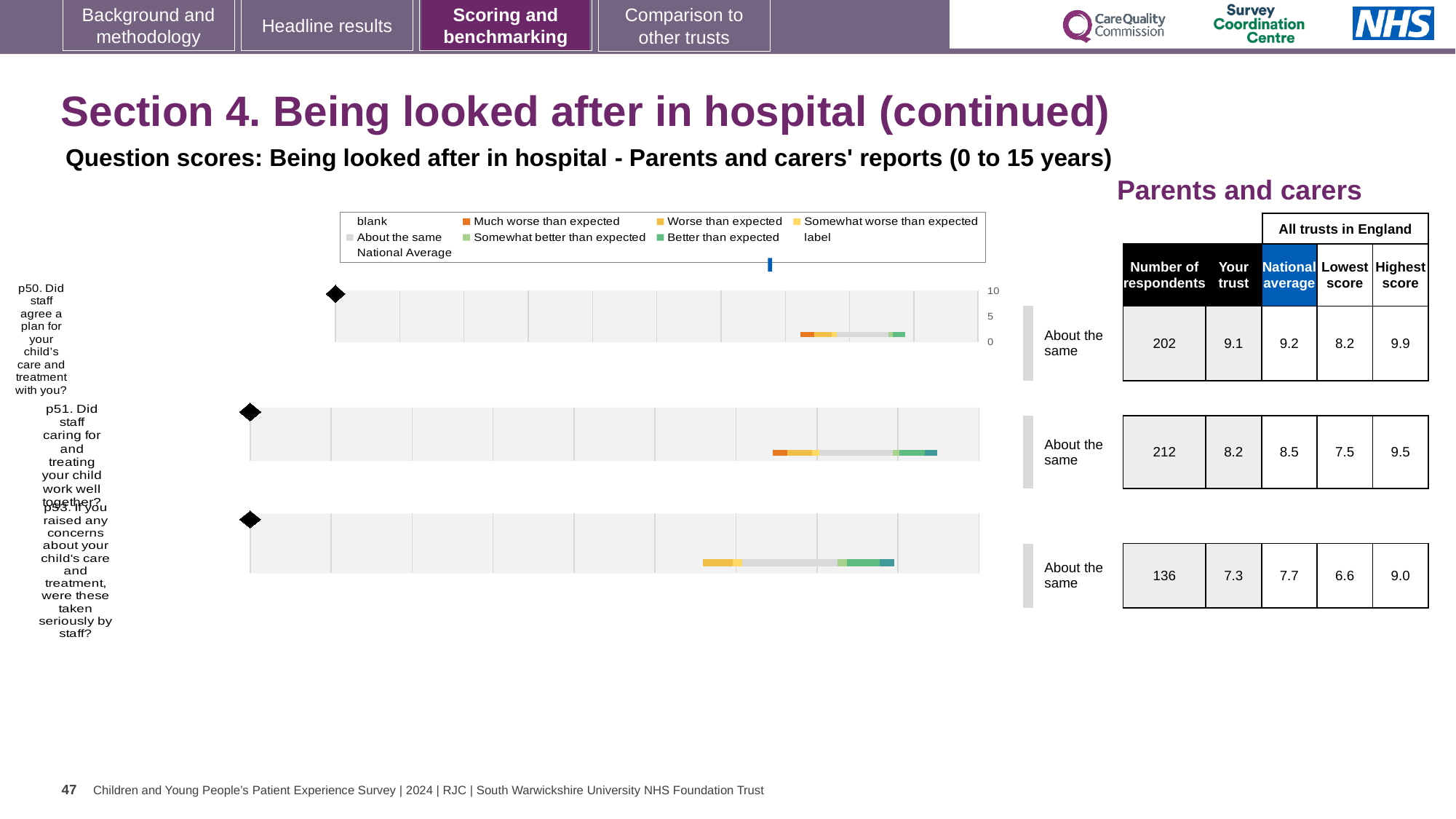
For the chart for p51, which is larger: the 'Your trust' score or the national average? National average For the chart for p53, what is the difference between the national average (7.7) and the 'Your trust' score (7.3)? 0.4 What kind of chart is used to show each question's score on this slide? Bar chart For the chart for p50, what is the lowest score among all trusts in England? 8.2 For the chart for p50 (Did staff agree a plan for your child's care and treatment with you?), what is the 'Your trust' score shown in the table? 9.1 For the chart for p53, what is the highest score among all trusts in England? 9.0 For the chart for p53 (If you raised any concerns about your child's care and treatment, were these taken seriously by staff?), how many respondents are listed? 136 Which of the three questions charted has the lowest number of respondents? p53 What benchmark rating is shown next to each of the three charts? About the same For the chart for p51 (Did staff caring for and treating your child work well together?), what is the national average score? 8.5 Which of the three questions charted has the highest 'Your trust' score? p50 How many questions are charted on this slide? 3